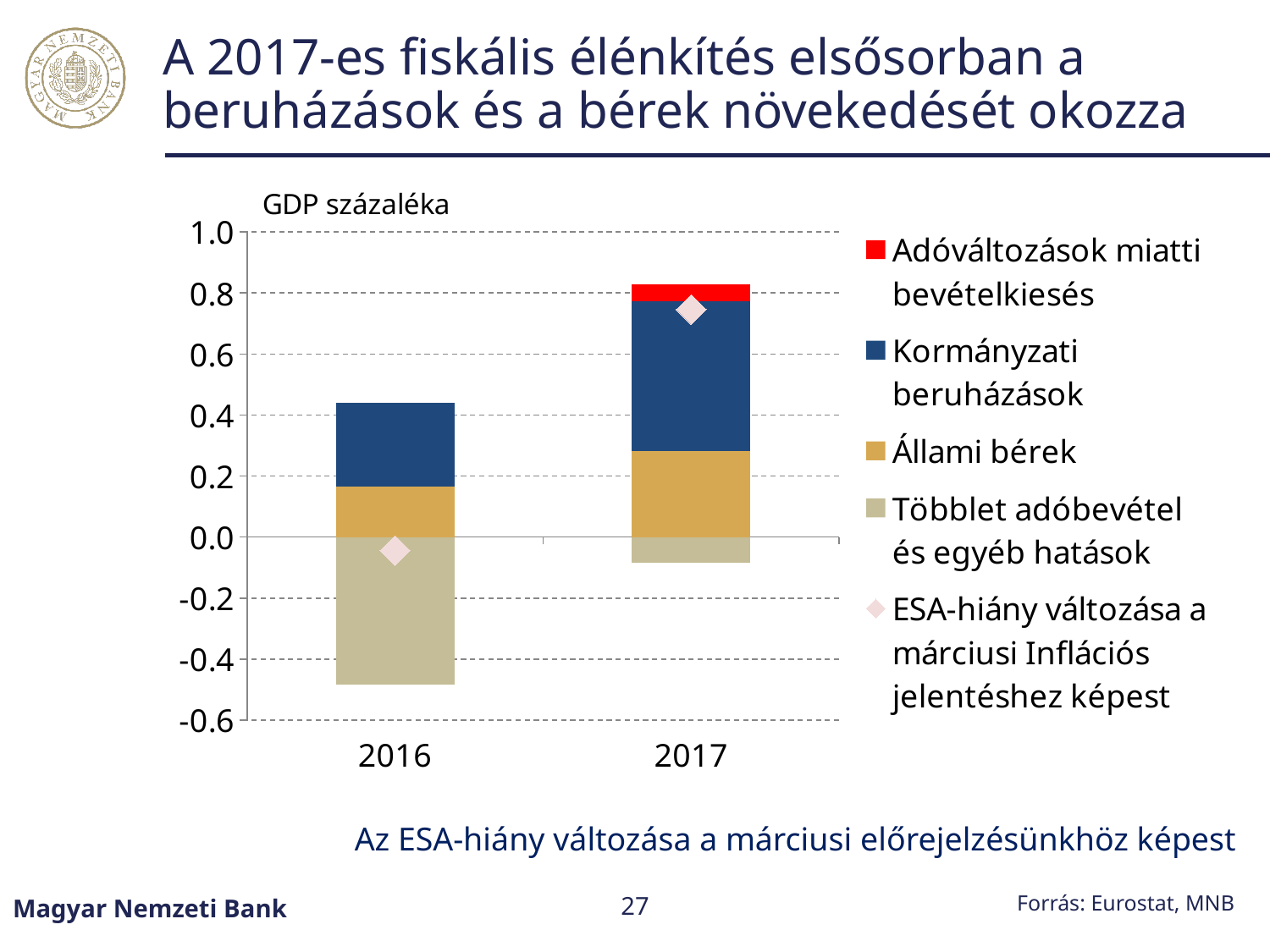
Is the Kormányzati beruházások segment larger in 2016 or in 2017? 2017 How many series does the legend list? 5 How many categories (years) are shown on the x axis? 2 Is the top of the stacked positive bar for 2017 greater or less than 0.8? greater Does the ESA-hiány változása marker rise or fall from 2016 to 2017? rise Is the Állami bérek segment larger in 2016 or in 2017? 2017 Which series is shown in red? Adóváltozások miatti bevételkiesés What kind of chart is shown on the slide? Stacked bar chart What unit is indicated above the vertical axis? GDP százaléka Is the ESA-hiány változása marker for 2016 greater or less than 0.0? less Is the ESA-hiány változása marker for 2017 greater or less than 0.6? greater